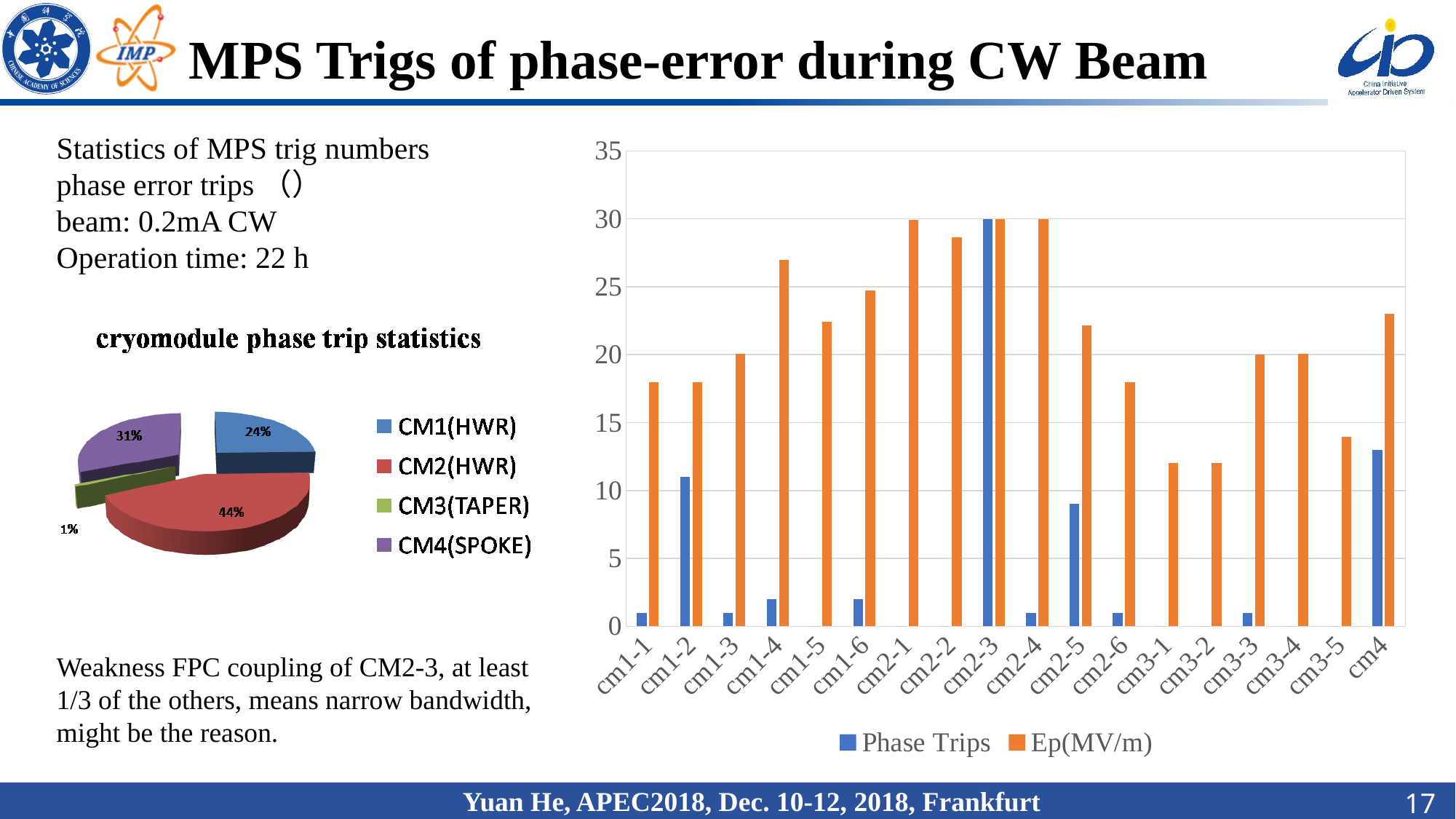
In the pie chart titled 'cryomodule phase trip statistics', which cryomodule has the largest share? CM2(HWR) In the bar chart on the right, how many series does the legend list? 2 In the pie chart titled 'cryomodule phase trip statistics', what share of phase trips is attributed to CM4(SPOKE)? 31% In the bar chart on the right, is the Ep(MV/m) value for cm1-4 greater or less than 25? greater In the bar chart on the right, which has more Phase Trips, cm1-2 or cm2-5? cm1-2 In the pie chart titled 'cryomodule phase trip statistics', what is the difference in percentage points between the CM2(HWR) share and the CM1(HWR) share? 20 In the pie chart titled 'cryomodule phase trip statistics', which cryomodule has the smallest share? CM3(TAPER) In the bar chart on the right, is the Phase Trips value for cm2-5 greater or less than 10? less In the pie chart titled 'cryomodule phase trip statistics', what share of phase trips is attributed to CM2(HWR)? 44% In the pie chart titled 'cryomodule phase trip statistics', how many slices are there? 4 In the bar chart on the right, which cavity has the highest number of Phase Trips? cm2-3 In the bar chart on the right, how many cavity categories are shown on the x axis? 18